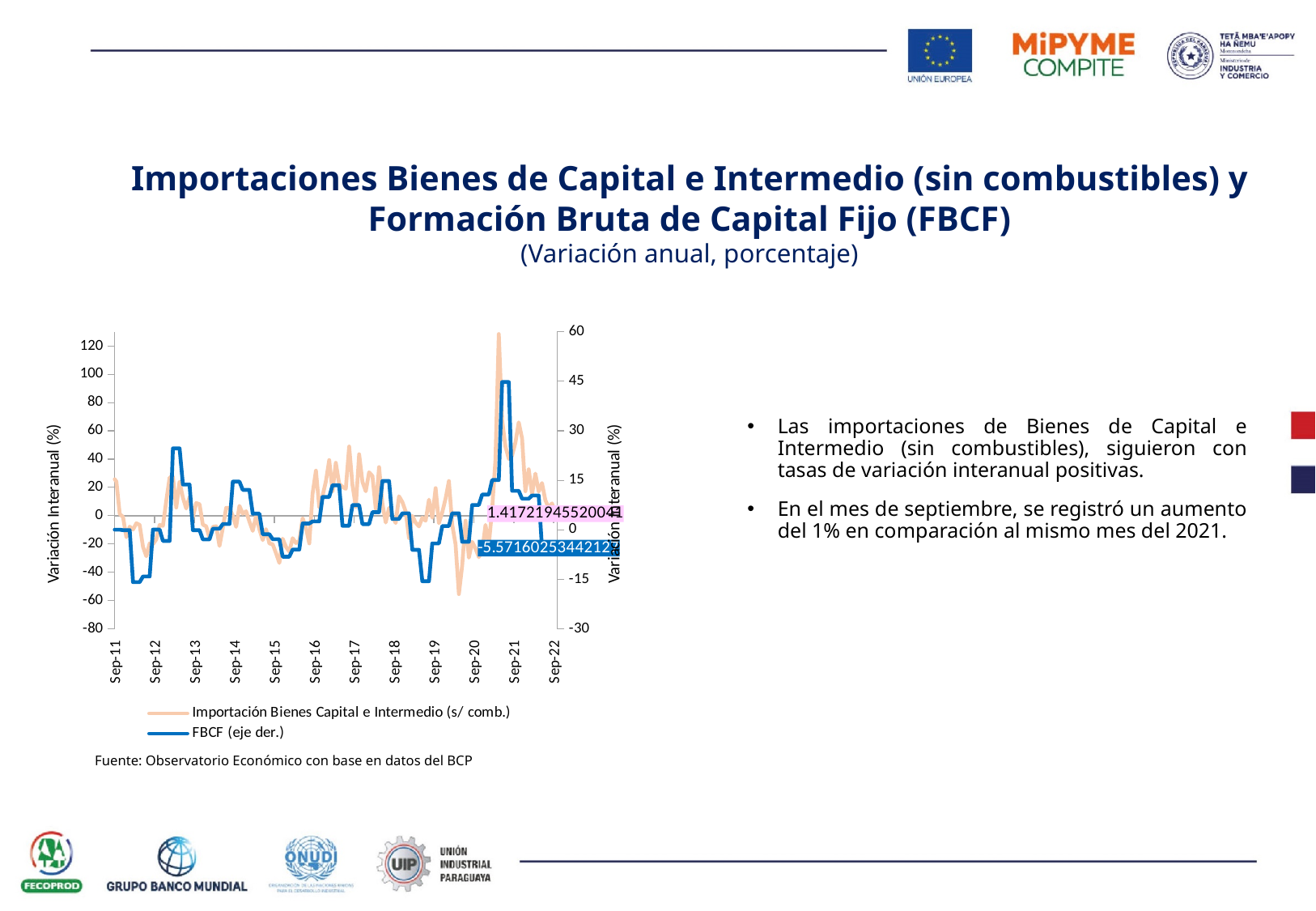
Which series has the larger labelled final value, Importación Bienes Capital e Intermedio (s/ comb.) or FBCF (eje der.)? Importación Bienes Capital e Intermedio (s/ comb.) How many date labels are shown on the x axis of the chart? 12 What is the data label shown for the last point of the FBCF (eje der.) series? -5.57160253442124 What is the data label shown for the last point of the Importación Bienes Capital e Intermedio (s/ comb.) series? 1.41721945520044 What is the highest tick value shown on the left vertical axis? 120 What kind of chart is shown on the slide? line chart Which series is plotted on the right-hand axis according to the legend? FBCF (eje der.) How many series does the chart legend list? 2 Does the Importación Bienes Capital e Intermedio (s/ comb.) series rise or fall between Sep-21 and Sep-22? fall Is the peak value of the FBCF (eje der.) series around Sep-21 greater or less than 30 on the right axis? greater Is the peak value of the Importación Bienes Capital e Intermedio (s/ comb.) series around Sep-20 to Sep-21 greater or less than 100 on the left axis? greater